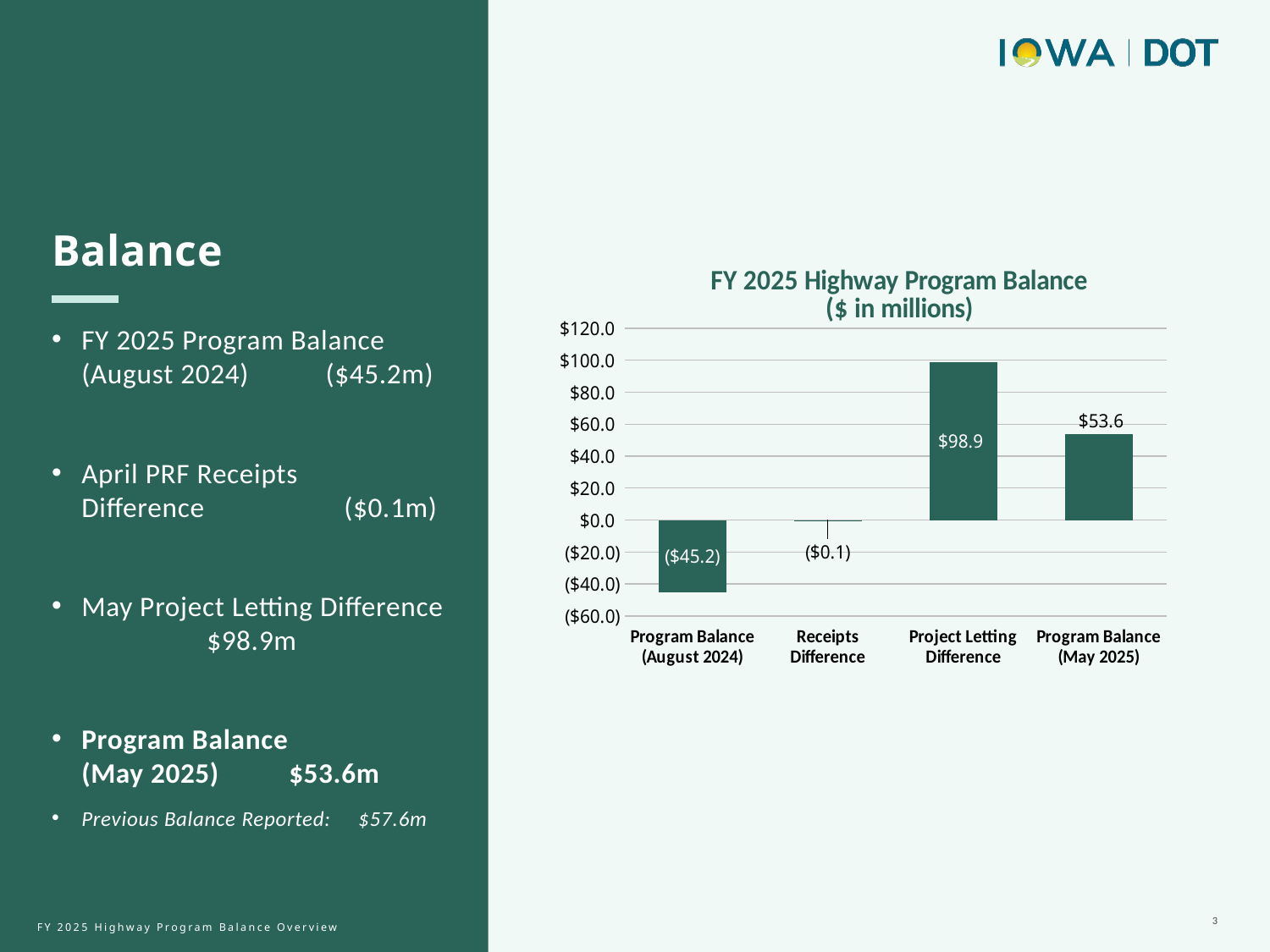
What is the difference between the Project Letting Difference value and the Program Balance (May 2025) value? $45.3 Is the value for Program Balance (May 2025) greater or less than $60.0? less What kind of chart is shown on the slide? bar chart Which is larger, the value for Project Letting Difference or the value for Program Balance (May 2025)? Project Letting Difference What is the value for Project Letting Difference in the FY 2025 Highway Program Balance chart? $98.9 What is the value for Program Balance (May 2025) in the chart? $53.6 How many categories are shown on the x axis of the chart? 4 What is the title of the chart on the slide? FY 2025 Highway Program Balance ($ in millions) Which category has the highest value in the FY 2025 Highway Program Balance chart? Project Letting Difference What is the value for Receipts Difference in the chart? ($0.1) Which category has the lowest value in the FY 2025 Highway Program Balance chart? Program Balance (August 2024) What is the value for Program Balance (August 2024) in the chart? ($45.2)